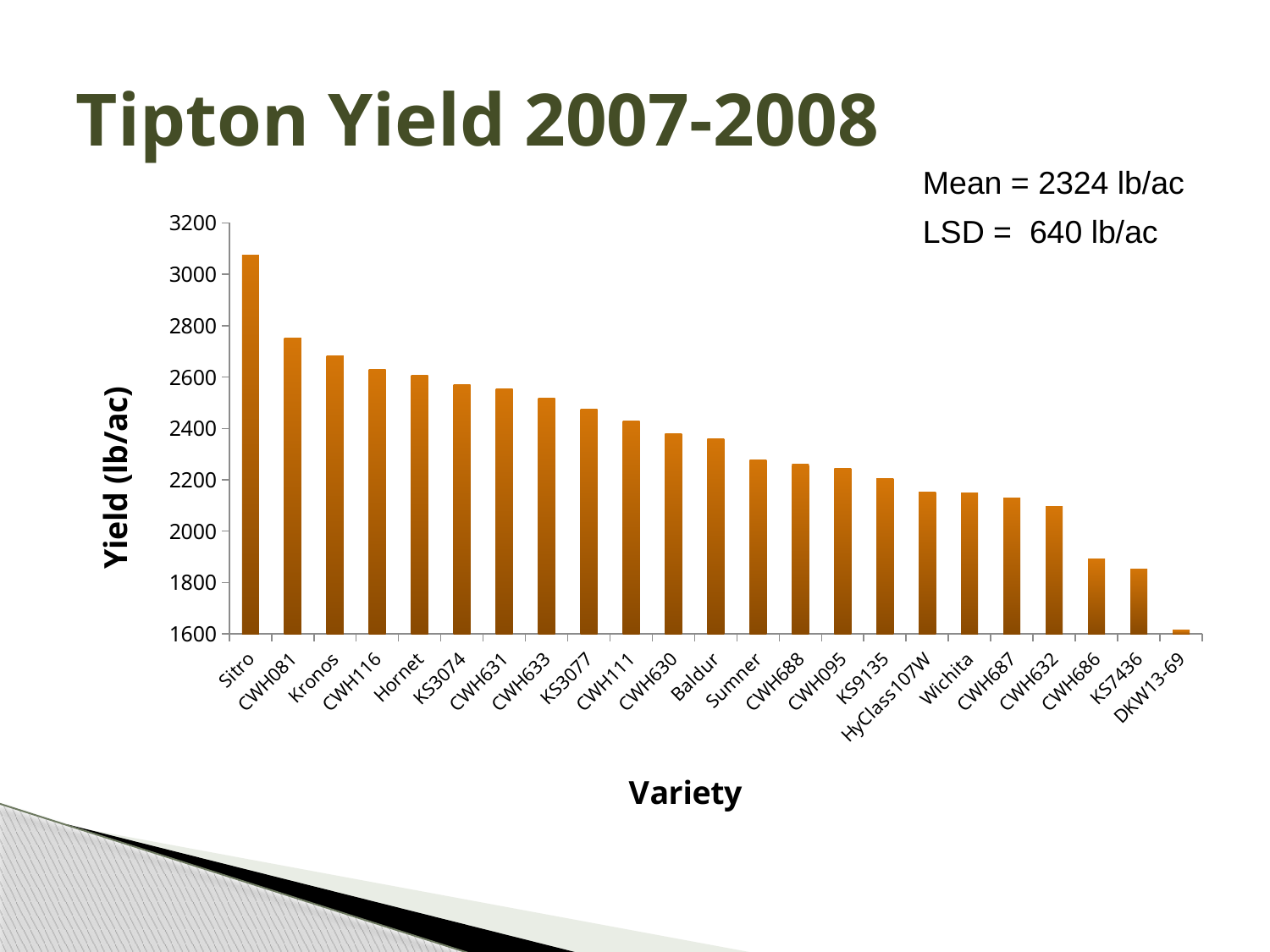
Which variety has a higher yield, Hornet or Baldur? Hornet Is the yield for CWH081 greater or less than 2800? less Is the yield for Sumner greater or less than 2200? greater How many varieties are plotted on the chart? 23 Is the yield for CWH686 greater or less than 2000? less Which variety has the lowest yield? DKW13-69 What is the label of the y axis? Yield (lb/ac) Which variety has the highest yield? Sitro What type of chart is shown on the slide? bar chart Do the yields rise or fall moving from left to right along the x axis? fall